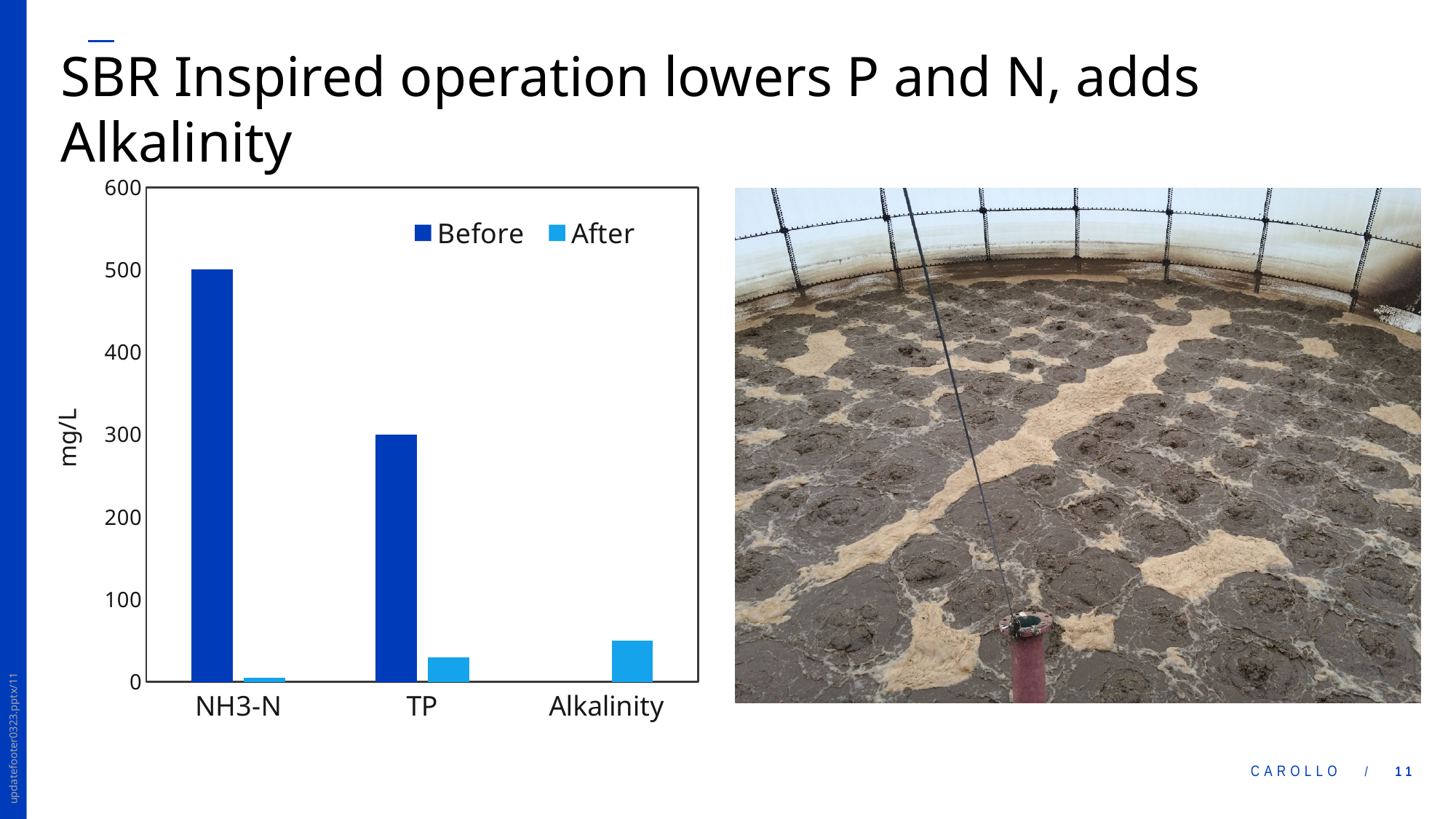
Which is larger, the After value for Alkalinity or the After value for TP? Alkalinity What is the Before value for TP? 300 Is the Before value for TP greater or less than 200? greater What kind of chart is shown on the slide? bar chart What is the label on the y axis of the chart? mg/L Is the After value for Alkalinity greater or less than 100? less How many series does the chart legend list? 2 Which category has the lowest After value? NH3-N Which category has the highest Before value? NH3-N What is the Before value for NH3-N? 500 How many categories are shown on the x axis of the chart? 3 Which is larger, the Before value for NH3-N or the Before value for TP? NH3-N